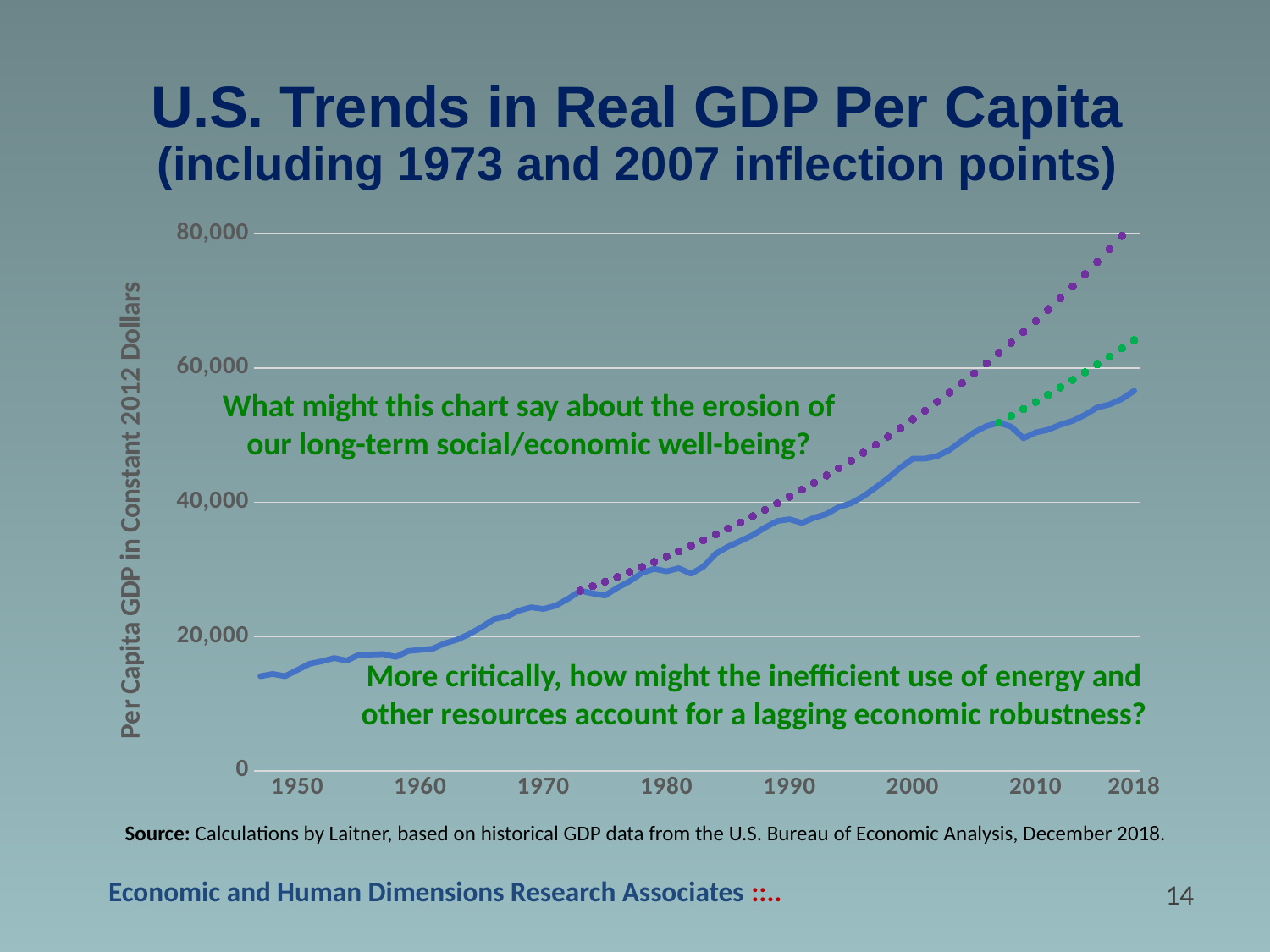
Is the value of the solid blue line in 1990 greater or less than 40,000? less What is the title of the chart? U.S. Trends in Real GDP Per Capita (including 1973 and 2007 inflection points) What kind of chart is shown on the slide? Line chart Is the value of the solid blue line in 1950 greater or less than 20,000? less What is the label on the vertical axis of the chart? Per Capita GDP in Constant 2012 Dollars In 2018, which is higher: the purple dotted trend line or the solid blue line? The purple dotted trend line How many lines are plotted on the chart? 3 Is the value of the solid blue line in 2000 greater or less than 40,000? greater Does the solid blue line for real GDP per capita generally rise or fall from 1950 to 2018? Rise At which year does the solid blue line reach its highest value? 2018